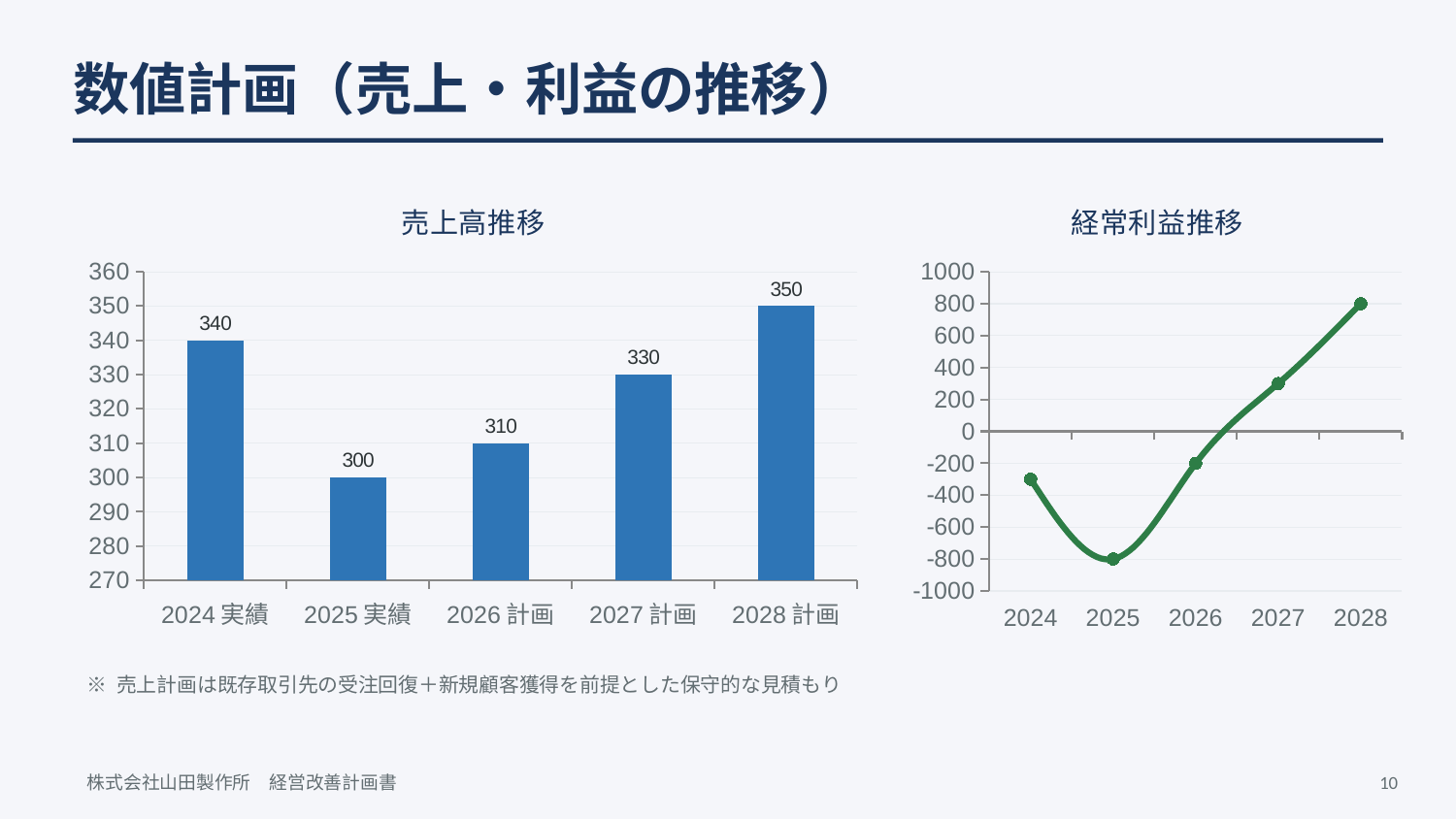
In the 売上高推移 chart, which category has the lowest value? 2025 実績 In the 経常利益推移 chart, do the values rise or fall from 2025 to 2028? rise In the 売上高推移 chart, what is the value for 2026 計画? 310 In the 経常利益推移 chart, is the value for 2027 greater or less than 200? greater How many bars are in the 売上高推移 chart? 5 In the 売上高推移 chart, what is the value for 2024 実績? 340 In the 売上高推移 chart, which category has the highest value? 2028 計画 In the 経常利益推移 chart, what is the value for 2025? -800 In the 売上高推移 chart, which is larger, the value for 2024 実績 or the value for 2027 計画? 2024 実績 What kind of chart is the 売上高推移 chart? bar chart In the 経常利益推移 chart, what is the value for 2028? 800 In the 売上高推移 chart, what is the difference between the values for 2028 計画 and 2025 実績? 50